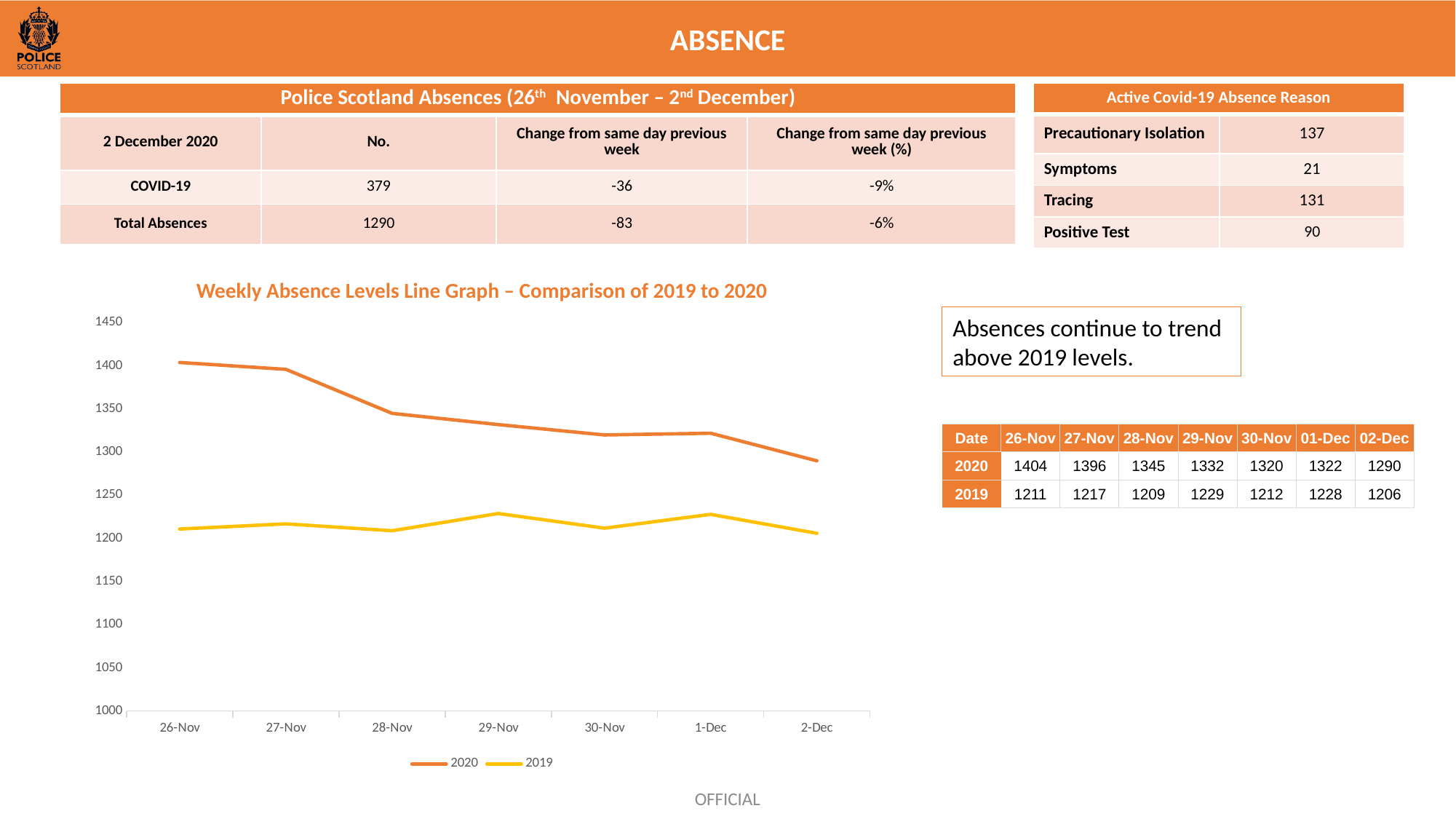
Which series is higher on 29-Nov in the Weekly Absence Levels chart, 2020 or 2019? 2020 On which date is the 2020 series highest in the Weekly Absence Levels chart? 26-Nov What is the difference between the 2020 and 2019 values on 26-Nov in the Weekly Absence Levels chart? 193 On which date is the 2020 series lowest in the Weekly Absence Levels chart? 2-Dec How many dates are plotted along the x axis of the Weekly Absence Levels chart? 7 Does the 2020 series generally rise or fall from 26-Nov to 2-Dec in the Weekly Absence Levels chart? fall How many series does the legend of the Weekly Absence Levels chart list? 2 What is the 2020 absence value on 26-Nov in the Weekly Absence Levels chart? 1404 What colour is the 2019 line in the Weekly Absence Levels chart? yellow Is the 2020 value on 28-Nov greater or less than 1300 in the Weekly Absence Levels chart? greater What kind of chart is the Weekly Absence Levels chart? line chart What is the 2019 absence value on 2-Dec in the Weekly Absence Levels chart? 1206